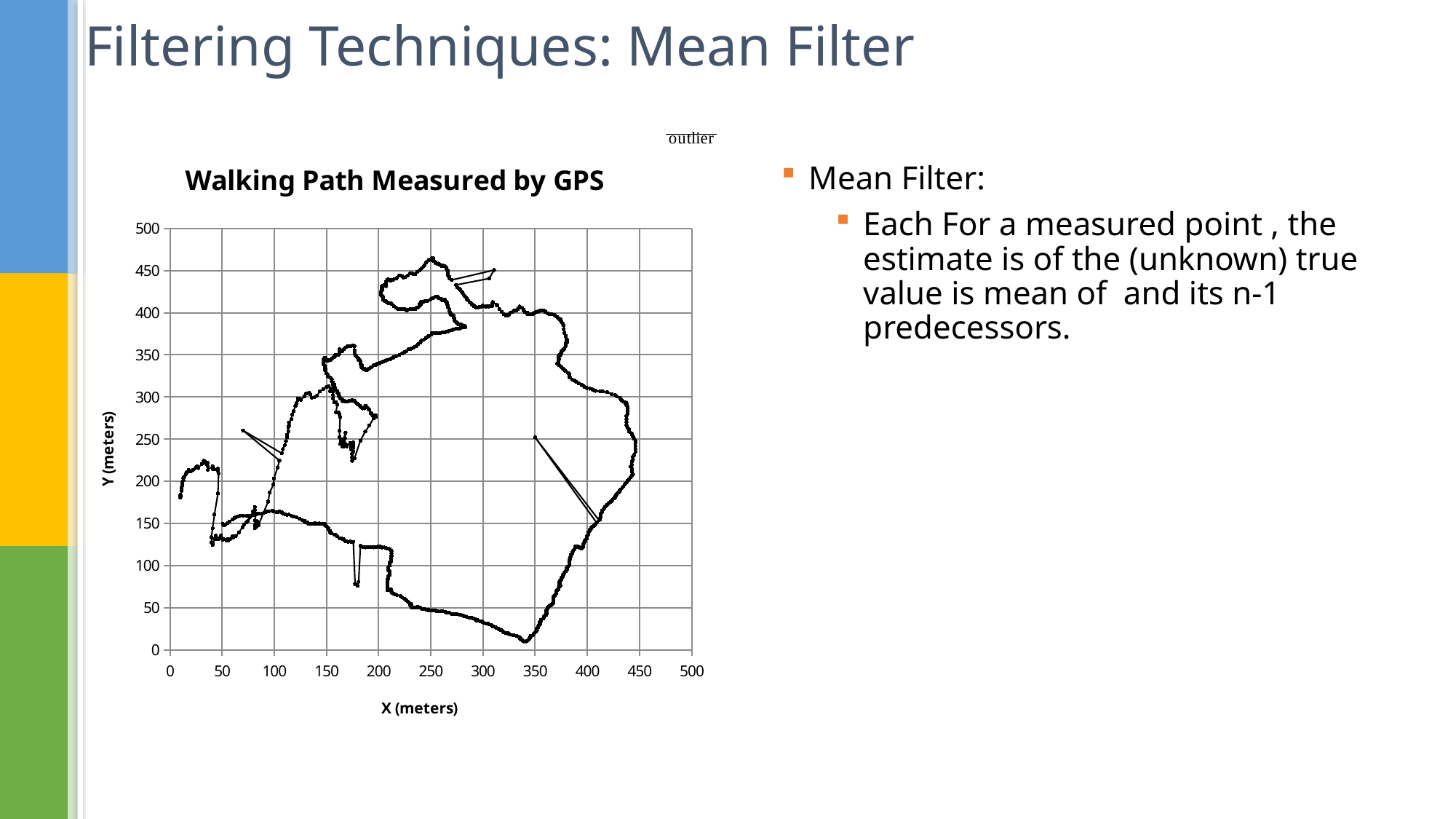
What is the label of the x axis of the chart? X (meters) Is the highest Y value reached by the walking path greater or less than 400? greater Is the highest Y value reached by the walking path greater or less than 500? less Is the largest X value reached by the walking path greater or less than 400? greater What is the title of the chart? Walking Path Measured by GPS What kind of chart is shown on the slide? scatter chart